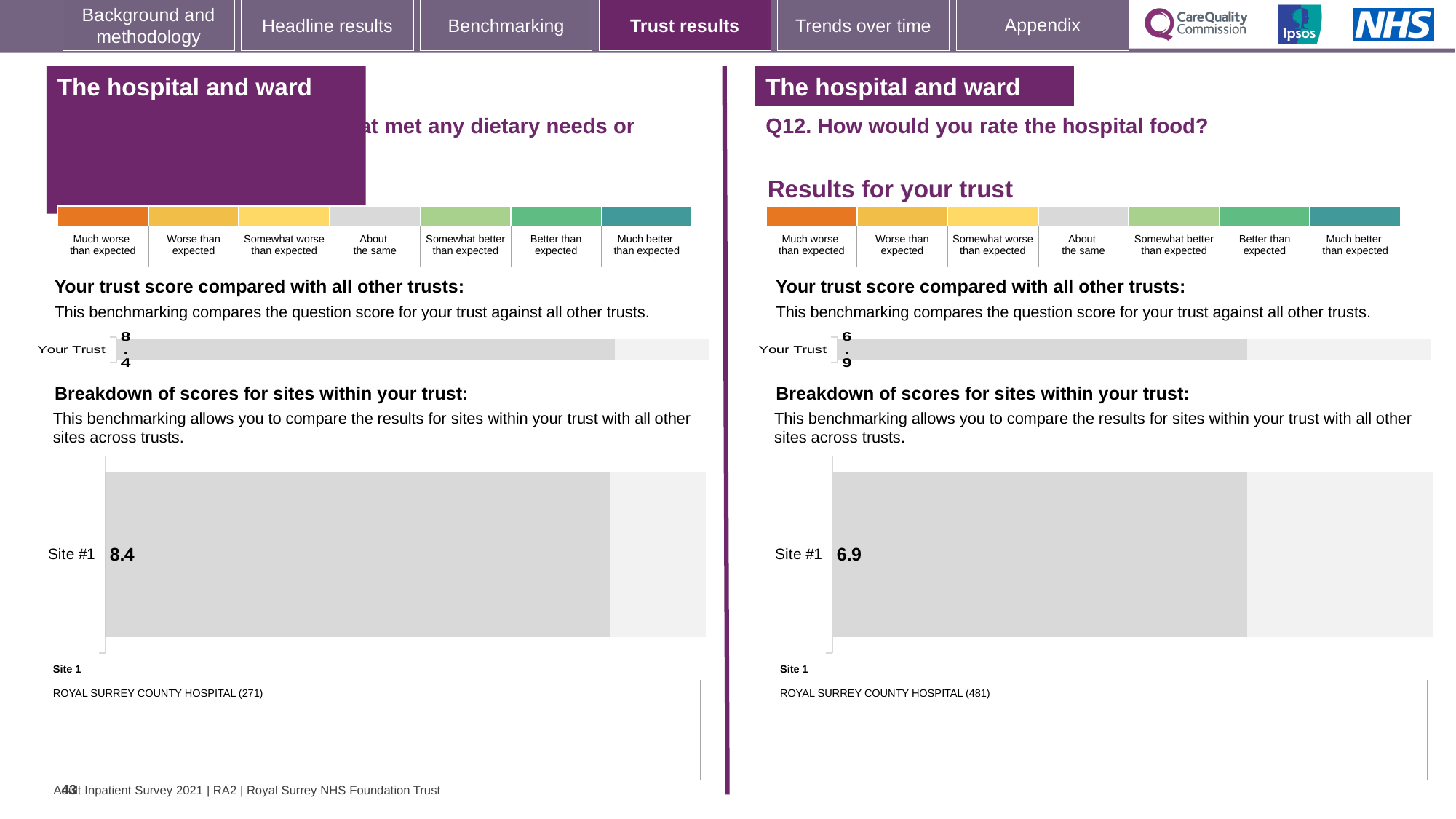
On the right-hand breakdown chart for Q12, what score is shown for Site #1? 6.9 On the right-hand Q12 chart, which hospital is listed as Site 1? ROYAL SURREY COUNTY HOSPITAL (481) On the right-hand Q12 breakdown chart, how many sites are shown? 1 On the left-hand breakdown chart (the dietary needs question), what score is shown for Site #1? 8.4 On the left-hand 'Your trust score compared with all other trusts' chart, how many bars are plotted? 1 Which Site #1 score is larger: the one on the left-hand chart or the one on the right-hand Q12 chart? The left-hand chart On the left-hand chart (the dietary needs question), what is the score shown for Your Trust? 8.4 How many categories does the colour scale above the right-hand Q12 chart show, from 'Much worse than expected' to 'Much better than expected'? 7 What type of chart is used to show the Site #1 score on the right-hand Q12 breakdown? Bar chart What is the difference between the Site #1 score on the left-hand chart (8.4) and the Site #1 score on the right-hand Q12 chart (6.9)? 1.5 On the right-hand chart for Q12 (How would you rate the hospital food?), what is the score shown for Your Trust? 6.9